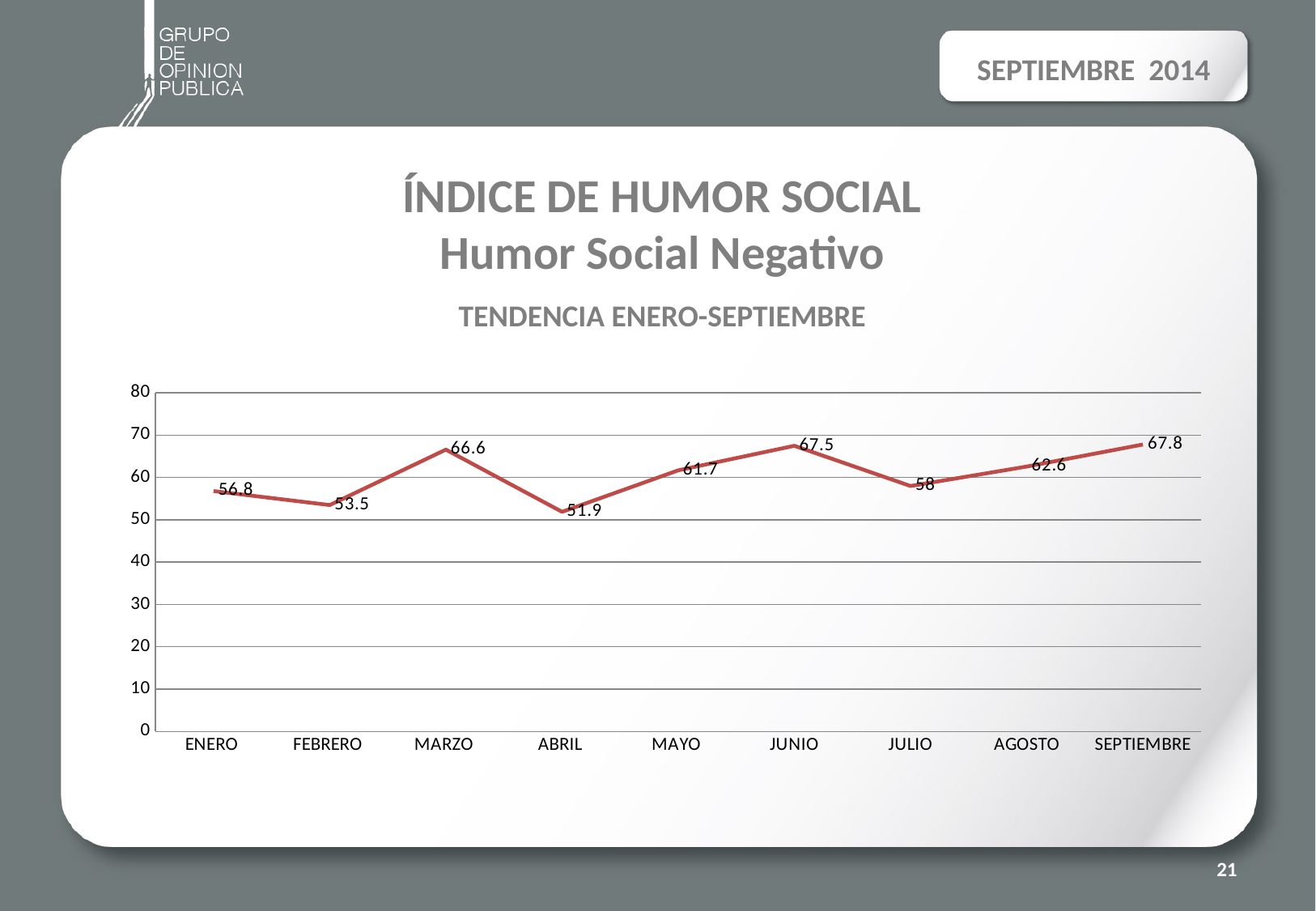
Which is larger, the value for MAYO or the value for AGOSTO? AGOSTO What is the value for ABRIL? 51.9 What is the value for MARZO? 66.6 What kind of chart is shown on the slide? line chart Which month has the lowest value? ABRIL What is the difference between the values for JUNIO and JULIO? 9.5 What is the difference between the values for SEPTIEMBRE and ENERO? 11 How many months are plotted on the chart? 9 What is the subtitle shown above the chart? TENDENCIA ENERO-SEPTIEMBRE What is the value for JULIO? 58 Is the value for FEBRERO greater or less than 60? less Which month has the highest value? SEPTIEMBRE